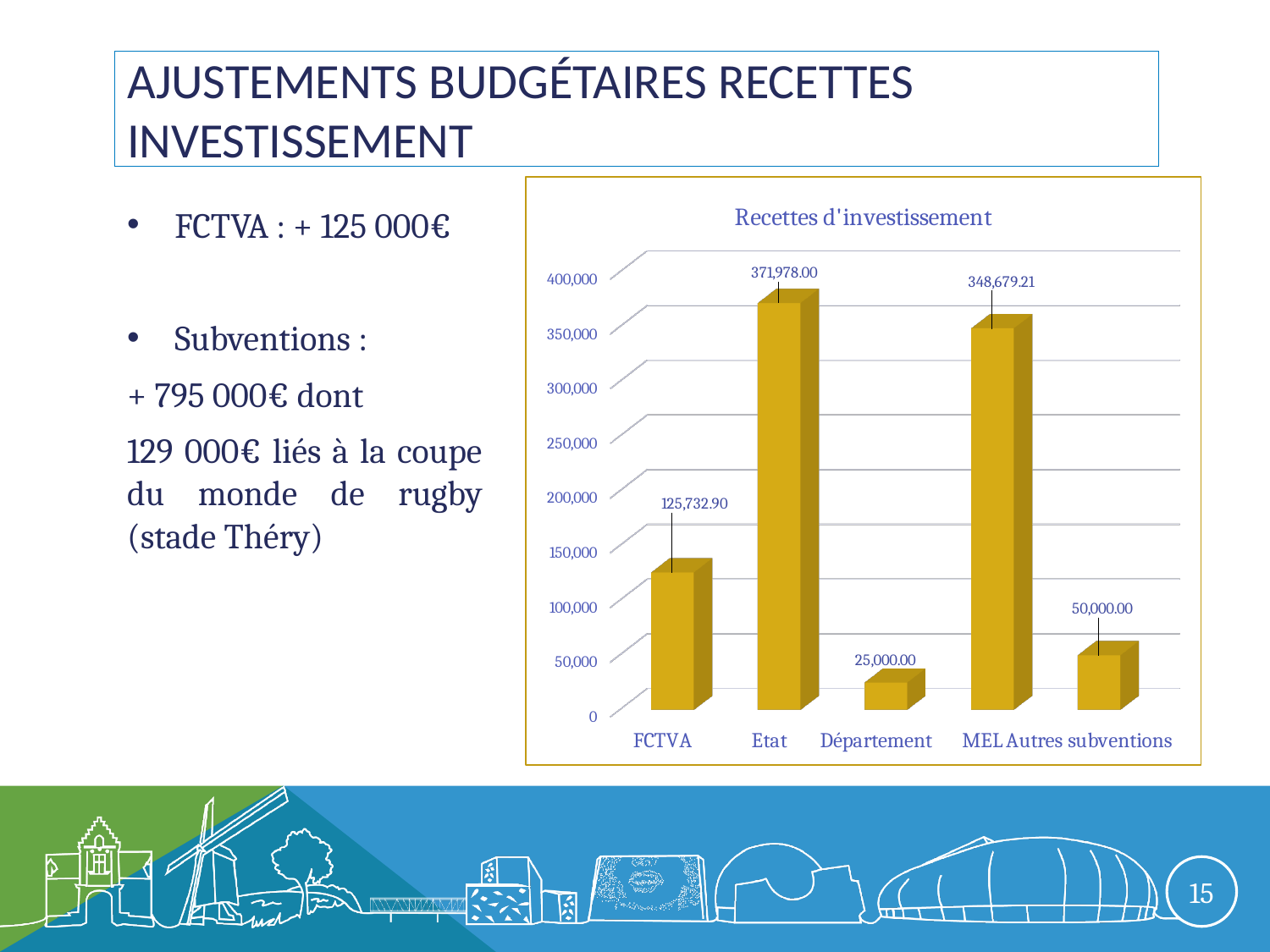
What kind of chart is the Recettes d'investissement chart? Bar chart What is the value for Département in the Recettes d'investissement chart? 25,000.00 What is the title of the chart on the slide? Recettes d'investissement What is the difference between the values for Autres subventions and Département in the Recettes d'investissement chart? 25,000.00 Which category has the highest value in the Recettes d'investissement chart? Etat What is the value for Etat in the Recettes d'investissement chart? 371,978.00 Which is larger in the Recettes d'investissement chart, FCTVA or Autres subventions? FCTVA How many categories are shown in the Recettes d'investissement chart? 5 What is the value for MEL in the Recettes d'investissement chart? 348,679.21 Which category has the lowest value in the Recettes d'investissement chart? Département What is the value for FCTVA in the Recettes d'investissement chart? 125,732.90 What is the difference between the values for Etat and MEL in the Recettes d'investissement chart? 23,298.79